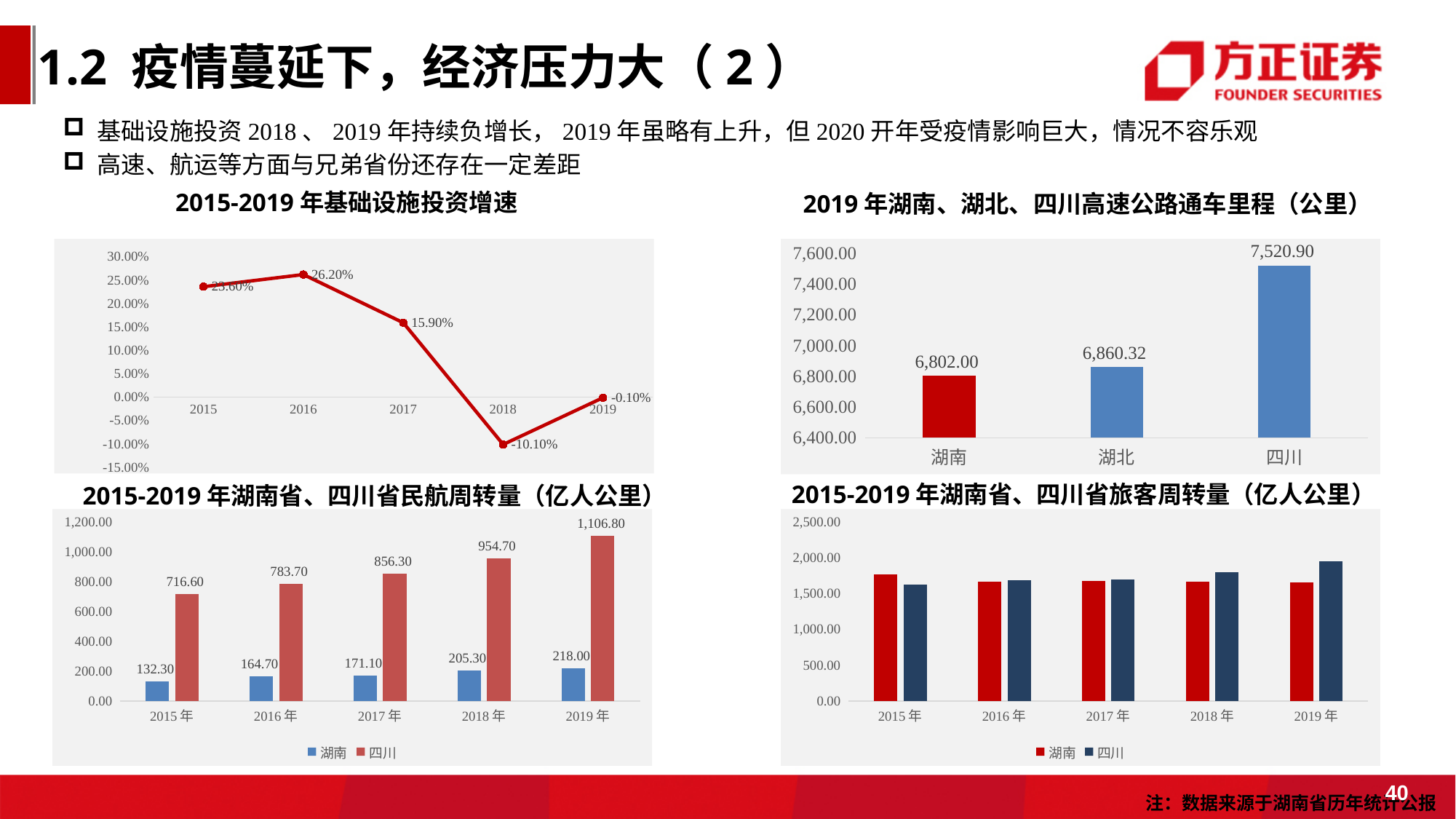
In the chart titled 2015-2019年湖南省、四川省民航周转量（亿人公里）, how do the values for 四川 change from 2015年 to 2019年? rise In the chart titled 2015-2019年湖南省、四川省旅客周转量（亿人公里）, is the value for 湖南 in 2015年 greater or less than 1,500.00? greater In the chart titled 2015-2019年湖南省、四川省民航周转量（亿人公里）, what is the value for 四川 in 2019年? 1,106.80 In the chart titled 2015-2019年湖南省、四川省民航周转量（亿人公里）, what is the value for 湖南 in 2016年? 164.70 In the chart titled 2015-2019年基础设施投资增速, what is the value for 2018? -10.10% In the chart titled 2015-2019年湖南省、四川省民航周转量（亿人公里）, how many series does the legend list? 2 In the chart titled 2015-2019年基础设施投资增速, which year has the highest value? 2016 In the chart titled 2019年湖南、湖北、四川高速公路通车里程（公里）, which province has the lowest value? 湖南 In the chart titled 2015-2019年湖南省、四川省旅客周转量（亿人公里）, how many years are shown on the x axis? 5 What kind of chart is the chart titled 2015-2019年基础设施投资增速? line chart In the chart titled 2019年湖南、湖北、四川高速公路通车里程（公里）, what is the value for 四川? 7,520.90 In the chart titled 2019年湖南、湖北、四川高速公路通车里程（公里）, what is the difference between 四川 and 湖南? 718.90